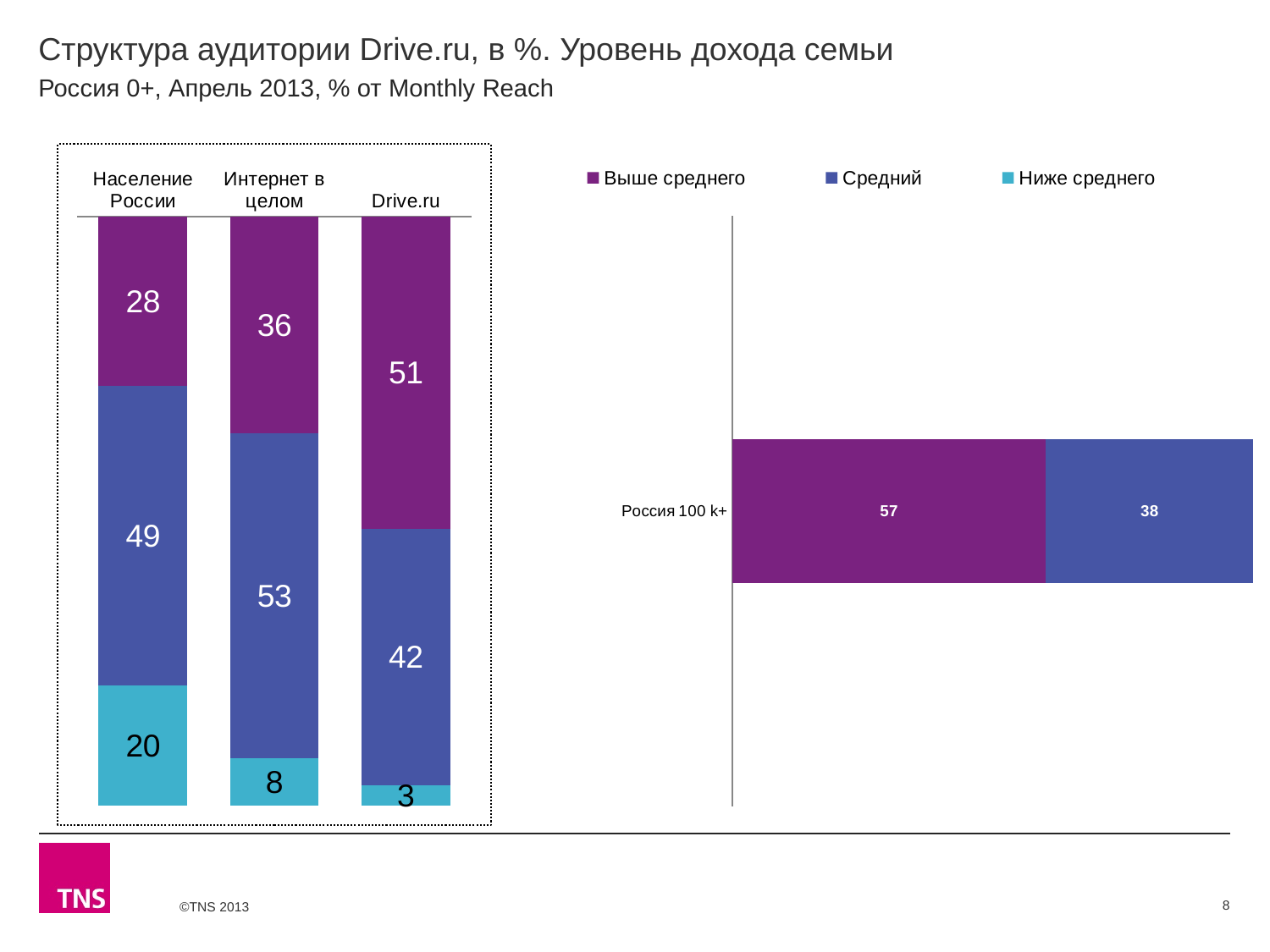
In the right chart, what is the 'Выше среднего' value for 'Россия 100 k+'? 57 In the left chart, what is the difference between the 'Средний' values for 'Интернет в целом' and Drive.ru? 11 In the left chart, which category has the lowest 'Ниже среднего' value? Drive.ru In the right chart, what is the 'Средний' value for 'Россия 100 k+'? 38 In the left chart, which category has the highest 'Выше среднего' value? Drive.ru How many categories are shown in the left chart? 3 In the left chart, which is larger: the 'Выше среднего' value for 'Население России' or for 'Интернет в целом'? Интернет в целом In the left chart, what is the value of the 'Средний' segment for 'Интернет в целом'? 53 In the left chart, what is the value of the 'Выше среднего' segment for Drive.ru? 51 In the left chart, what is the value of the 'Ниже среднего' segment for 'Население России'? 20 What type of chart is the left chart? Stacked bar chart How many series does the legend list? 3